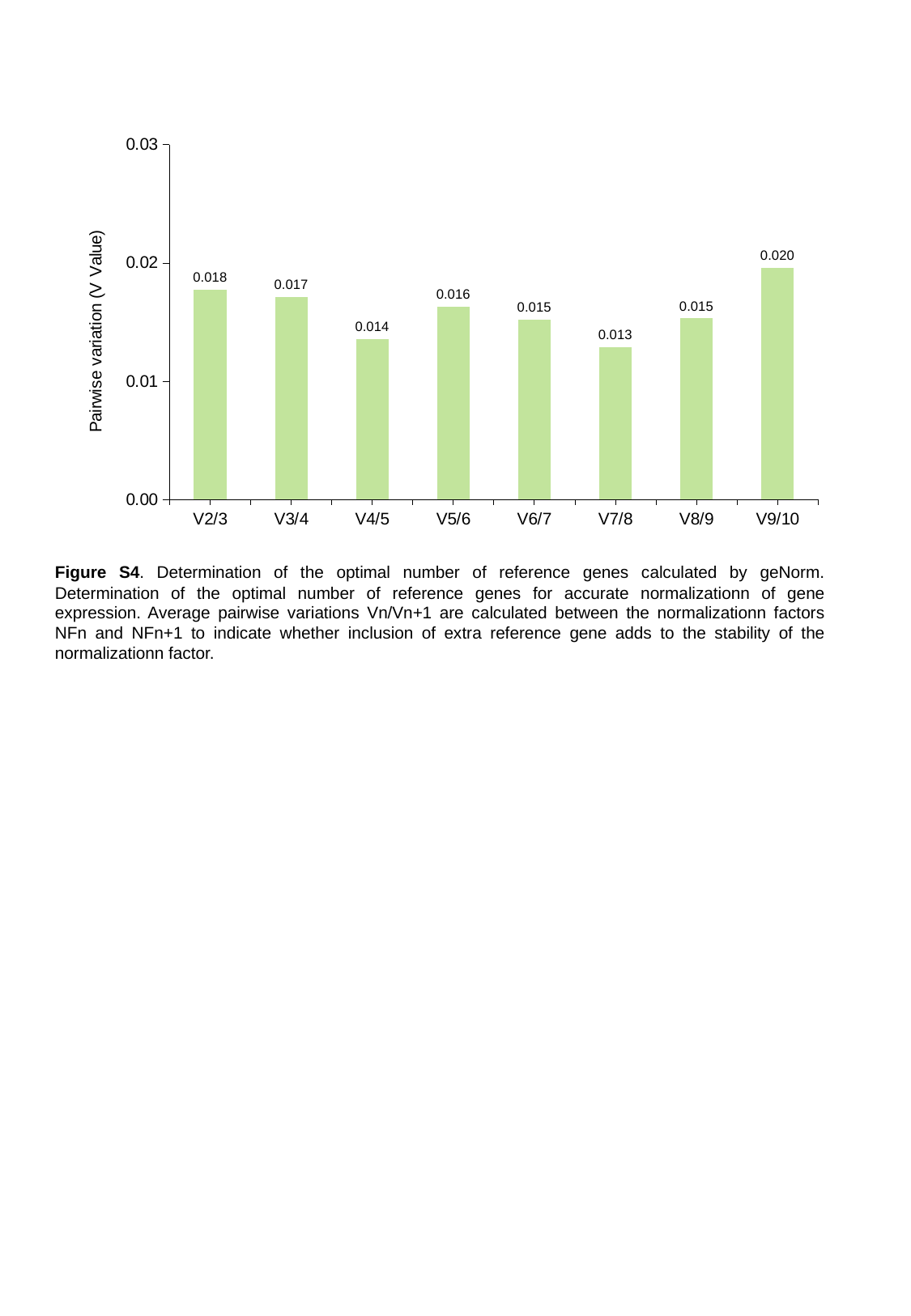
What kind of chart is shown on the slide? bar chart How many categories are shown on the x axis? 8 What is the pairwise variation value for V5/6? 0.016 What is the pairwise variation value for V7/8? 0.013 What is the label of the y axis? Pairwise variation (V Value) What is the difference between the values for V9/10 and V7/8? 0.007 Which has a larger pairwise variation value, V2/3 or V4/5? V2/3 Which category has the highest pairwise variation value? V9/10 What is the pairwise variation value for V9/10? 0.020 What is the pairwise variation value for V2/3? 0.018 Is the value for V9/10 greater or less than 0.01? greater Which category has the lowest pairwise variation value? V7/8